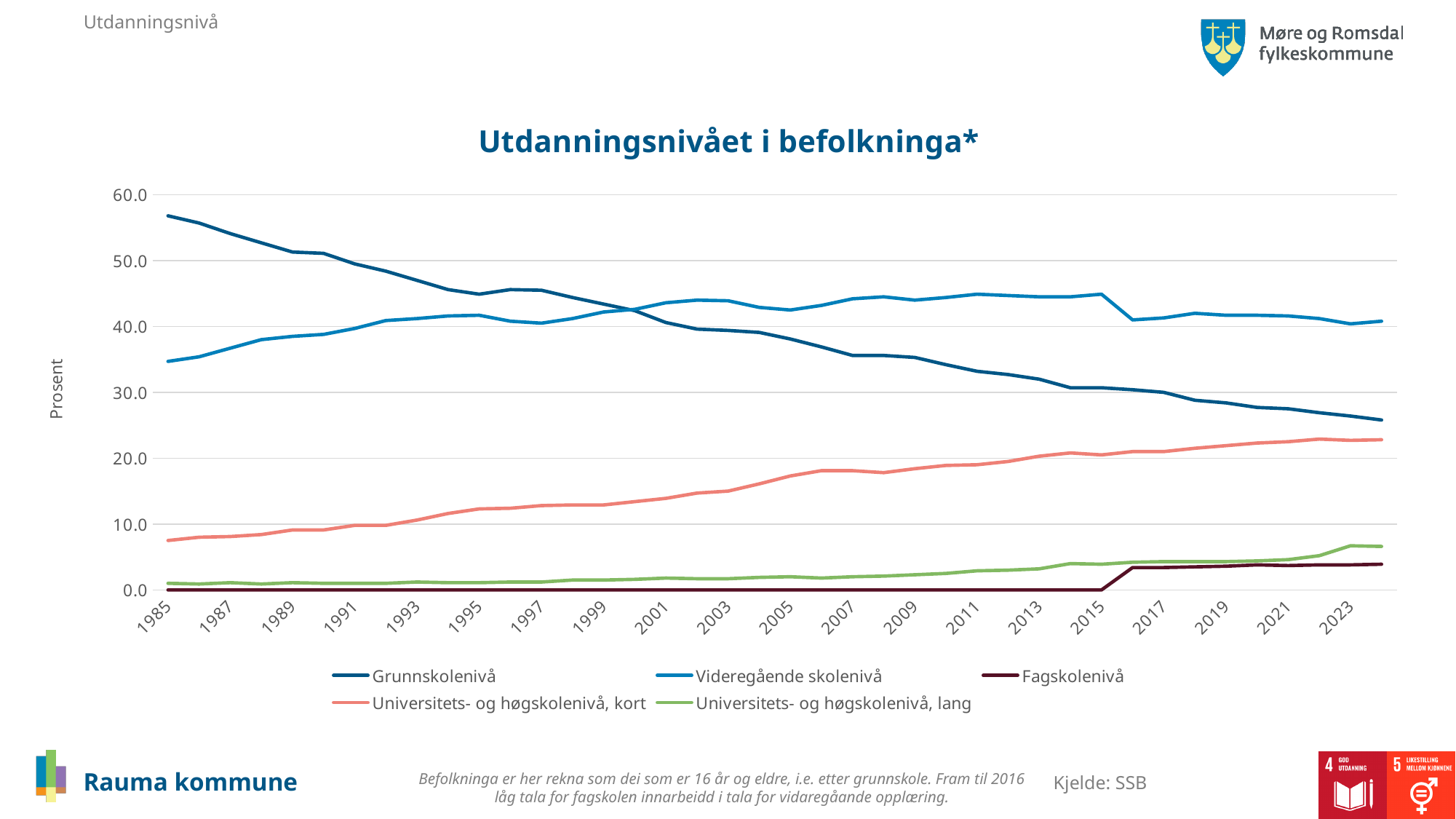
Is the value for Videregående skolenivå in 2015 greater or less than 40.0? greater Is the value for Grunnskolenivå in 1985 greater or less than 50.0? greater Which series has the highest value in 2023? Videregående skolenivå Does the Universitets- og høgskolenivå, kort series rise or fall from 1985 to 2023? rise Is the value for Grunnskolenivå in 2023 greater or less than 30.0? less What is the label on the vertical axis? Prosent In 1985, which is larger: Grunnskolenivå or Videregående skolenivå? Grunnskolenivå Does the Grunnskolenivå series rise or fall from 1985 to 2023? fall How many series does the legend list? 5 What is the title of the chart? Utdanningsnivået i befolkninga* What kind of chart is shown on the slide? line chart Which series has the lowest value in 1985? Fagskolenivå